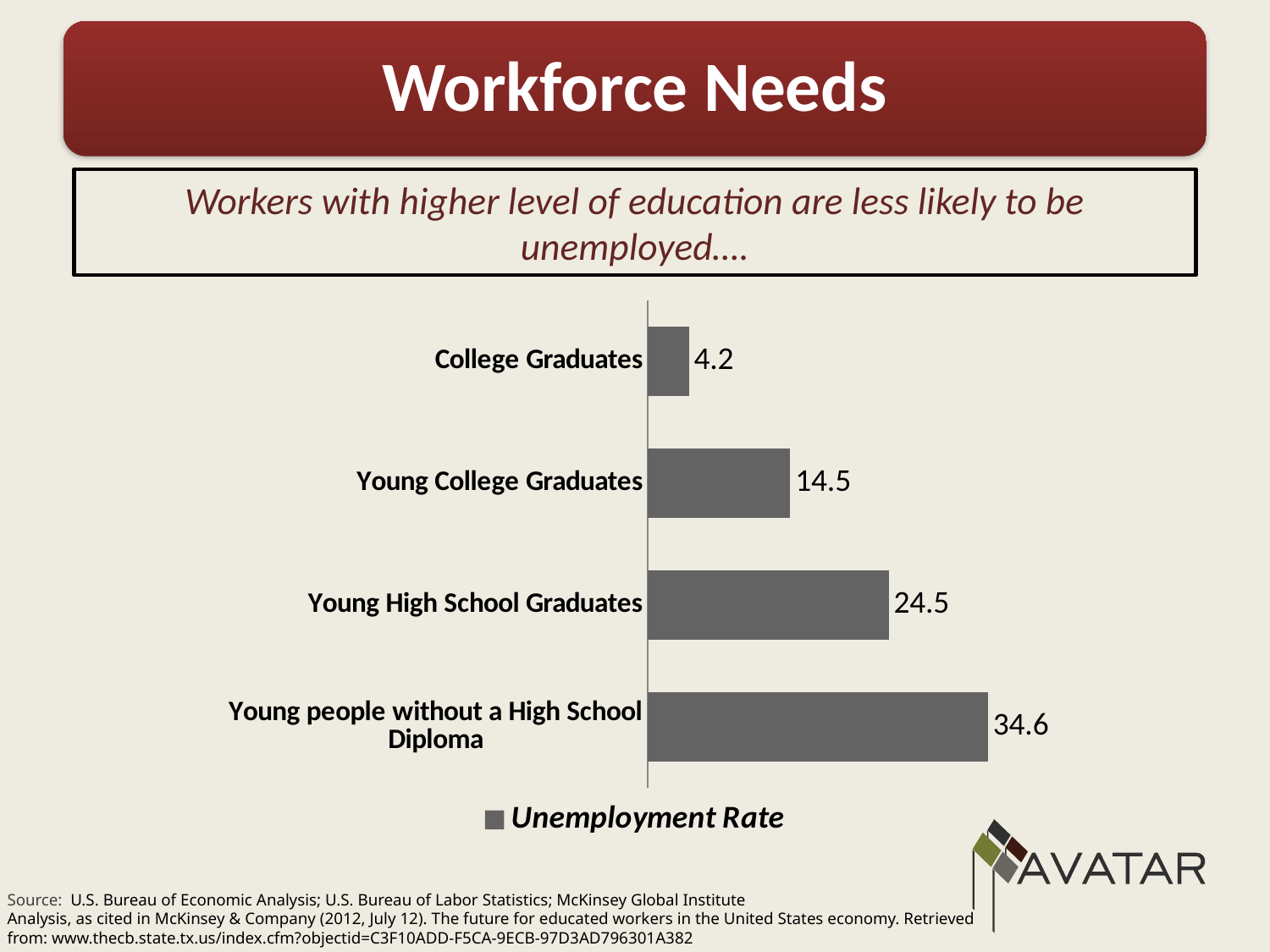
What is the unemployment rate for Young people without a High School Diploma? 34.6 Which has a higher unemployment rate, Young High School Graduates or Young College Graduates? Young High School Graduates What is the unemployment rate for Young High School Graduates? 24.5 What series name is shown in the chart legend? Unemployment Rate What is the difference in unemployment rate between Young College Graduates and College Graduates? 10.3 Which category has the lowest unemployment rate? College Graduates What is the unemployment rate for College Graduates? 4.2 What type of chart is shown on the slide? Bar chart How many categories are shown in the chart? 4 What is the difference in unemployment rate between Young people without a High School Diploma and Young High School Graduates? 10.1 Which category has the highest unemployment rate? Young people without a High School Diploma What is the unemployment rate for Young College Graduates? 14.5